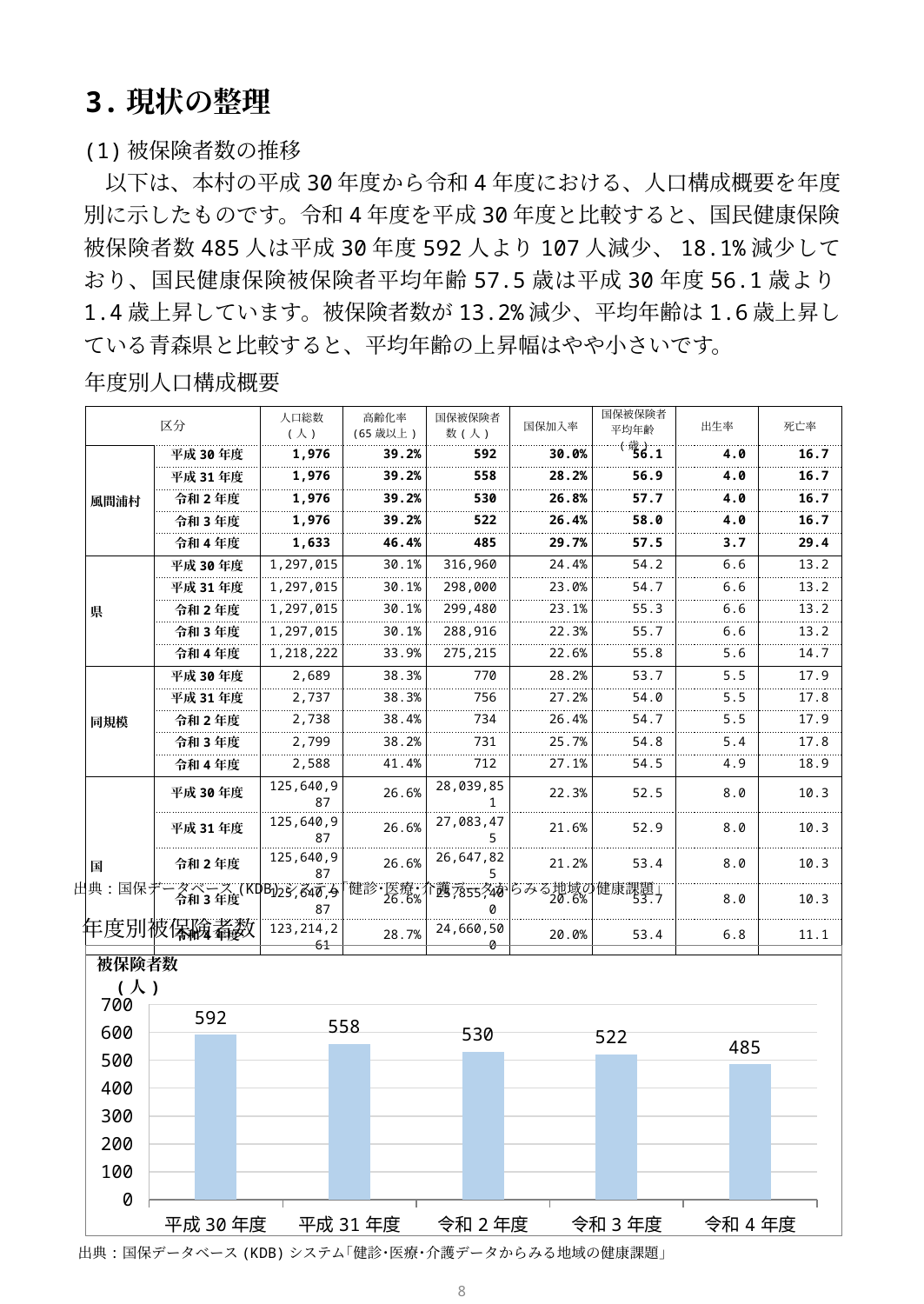
What is the value for 平成30年度 in the bar chart? 592 Which fiscal year has the highest value in the bar chart? 平成30年度 Is the value for 令和4年度 in the bar chart greater or less than 500? less Which is larger in the bar chart, the value for 平成31年度 or the value for 令和3年度? 平成31年度 What is the difference between the values for 平成30年度 and 令和4年度 in the bar chart? 107 What is the value for 令和4年度 in the bar chart? 485 Which fiscal year has the lowest value in the bar chart? 令和4年度 What is the difference between the values for 平成31年度 and 令和2年度 in the bar chart? 28 What is the value for 令和2年度 in the bar chart? 530 Do the values in the bar chart rise or fall from 平成30年度 to 令和4年度? fall What kind of chart is shown on the slide? bar chart How many fiscal years are shown in the bar chart? 5